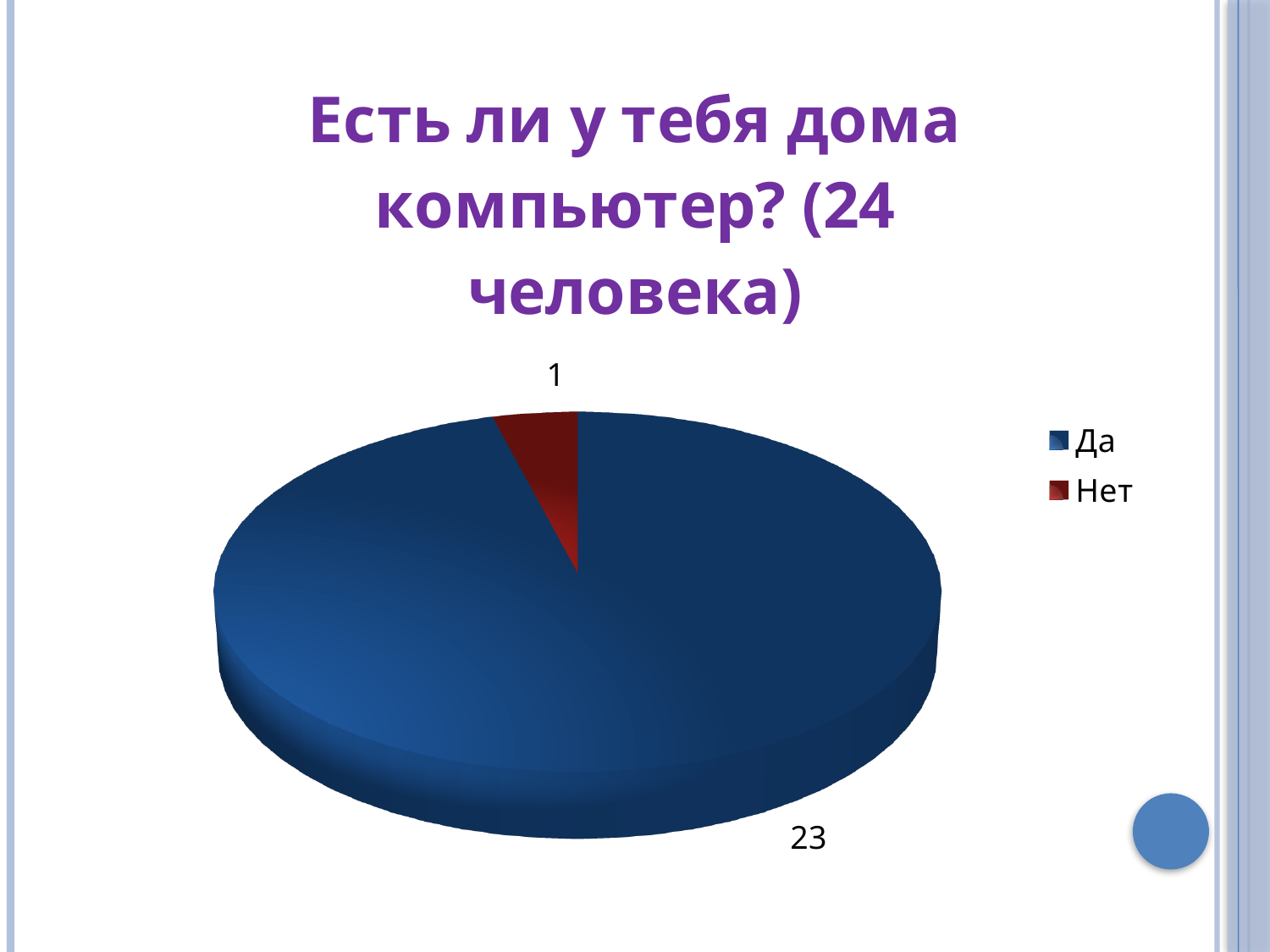
What colour is the slice for "Нет"? red Which answer has the largest slice of the pie? Да How many entries does the legend list? 2 What is the total of all slices in the pie chart? 24 Which answer has the smallest slice of the pie? Нет Which is larger, the value for "Да" or the value for "Нет"? Да What is the title of the chart? Есть ли у тебя дома компьютер? (24 человека) How many slices does the pie chart have? 2 How many people answered "Да"? 23 What kind of chart is shown on the slide? pie chart What is the difference between the number of "Да" and "Нет" answers? 22 How many people answered "Нет"? 1